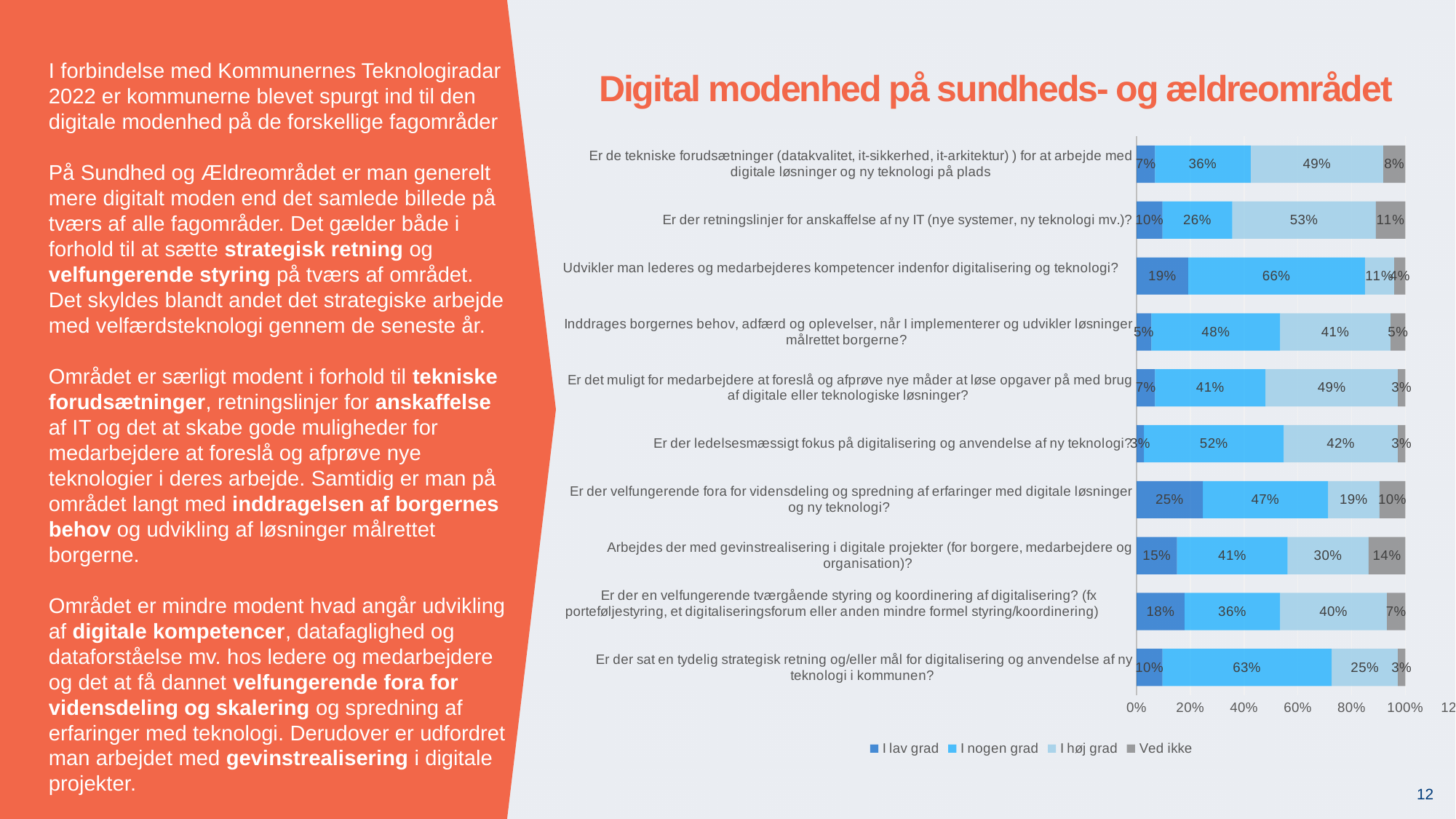
Which is larger: the 'I høj grad' value for 'Er de tekniske forudsætninger ... på plads' or for 'Er der en velfungerende tværgående styring og koordinering af digitalisering?' Er de tekniske forudsætninger ... på plads What is the combined 'I lav grad' and 'I nogen grad' share for 'Er der ledelsesmæssigt fokus på digitalisering og anvendelse af ny teknologi?' 55% How many series does the legend list? 4 What is the 'I nogen grad' value for 'Udvikler man lederes og medarbejderes kompetencer indenfor digitalisering og teknologi?' 66% What is the 'I høj grad' value for 'Er der retningslinjer for anskaffelse af ny IT (nye systemer, ny teknologi mv.)?' 53% Which category has the highest 'I lav grad' value? Er der velfungerende fora for vidensdeling og spredning af erfaringer med digitale løsninger og ny teknologi? What is the 'Ved ikke' value for 'Arbejdes der med gevinstrealisering i digitale projekter (for borgere, medarbejdere og organisation)?' 14% Which category has the lowest 'I høj grad' value? Udvikler man lederes og medarbejderes kompetencer indenfor digitalisering og teknologi? What is the difference between the 'I nogen grad' value for 'Er der sat en tydelig strategisk retning og/eller mål for digitalisering og anvendelse af ny teknologi i kommunen?' and its 'I høj grad' value? 38% What kind of chart is shown on the slide? Stacked bar chart How many question categories are plotted on the chart? 10 What is the title of the chart? Digital modenhed på sundheds- og ældreområdet